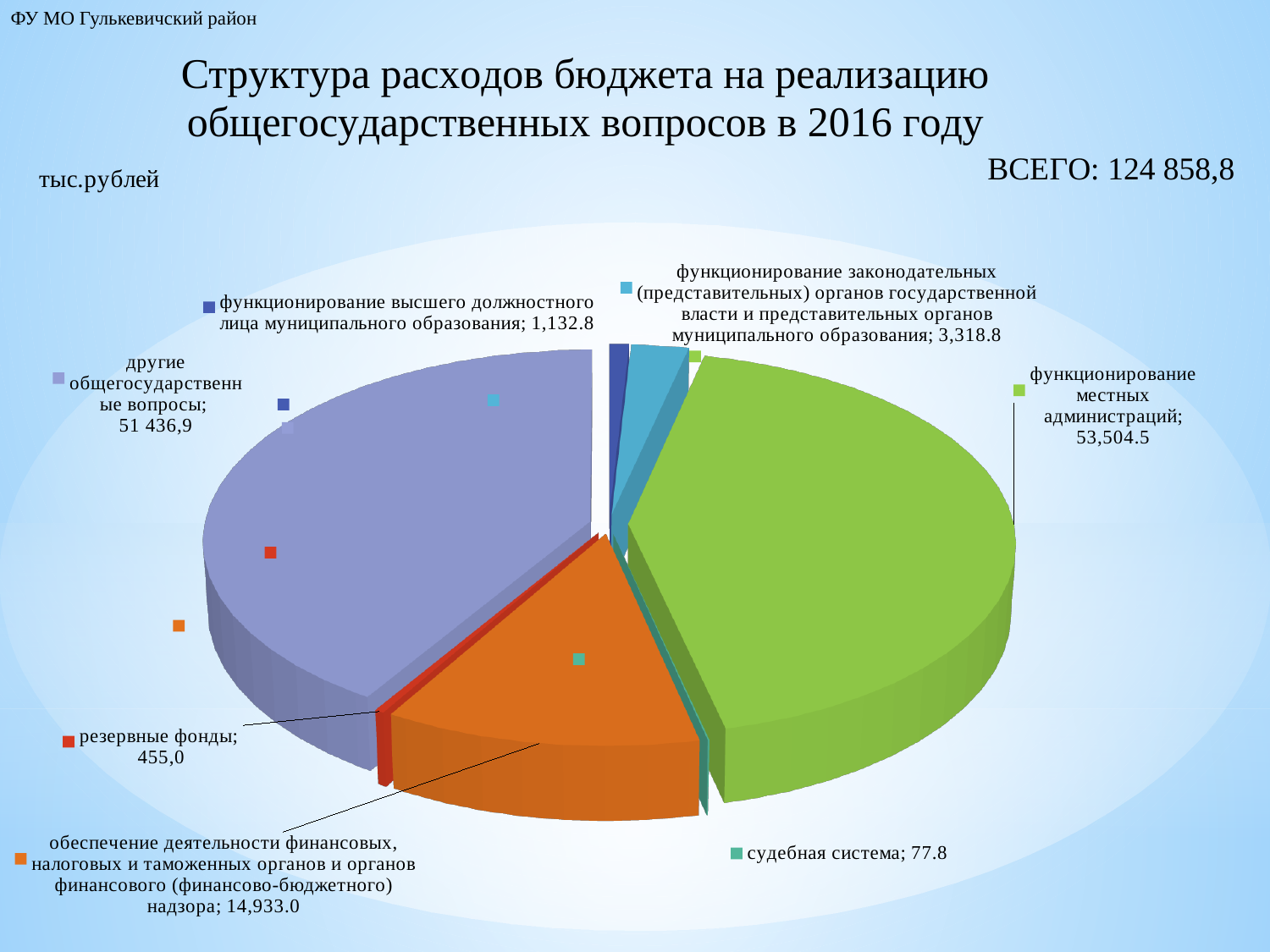
Which category has the largest value in the pie chart? функционирование местных администраций Which is larger: the value for "функционирование высшего должностного лица муниципального образования" or the value for "резервные фонды"? функционирование высшего должностного лица муниципального образования What is the value for "резервные фонды"? 455,0 What is the value for "функционирование местных администраций"? 53,504.5 What is the difference between the value for "обеспечение деятельности финансовых, налоговых и таможенных органов и органов финансового (финансово-бюджетного) надзора" and the value for "функционирование законодательных (представительных) органов государственной власти и представительных органов муниципального образования"? 11,614.2 What is the value for "другие общегосударственные вопросы"? 51 436,9 In what units are the values on the slide expressed? тыс.рублей What kind of chart is shown on the slide? Pie chart How many categories (slices) does the pie chart have? 7 What total value (ВСЕГО) is stated on the slide? 124 858,8 Which category has the smallest value in the pie chart? судебная система What is the value for "судебная система"? 77.8